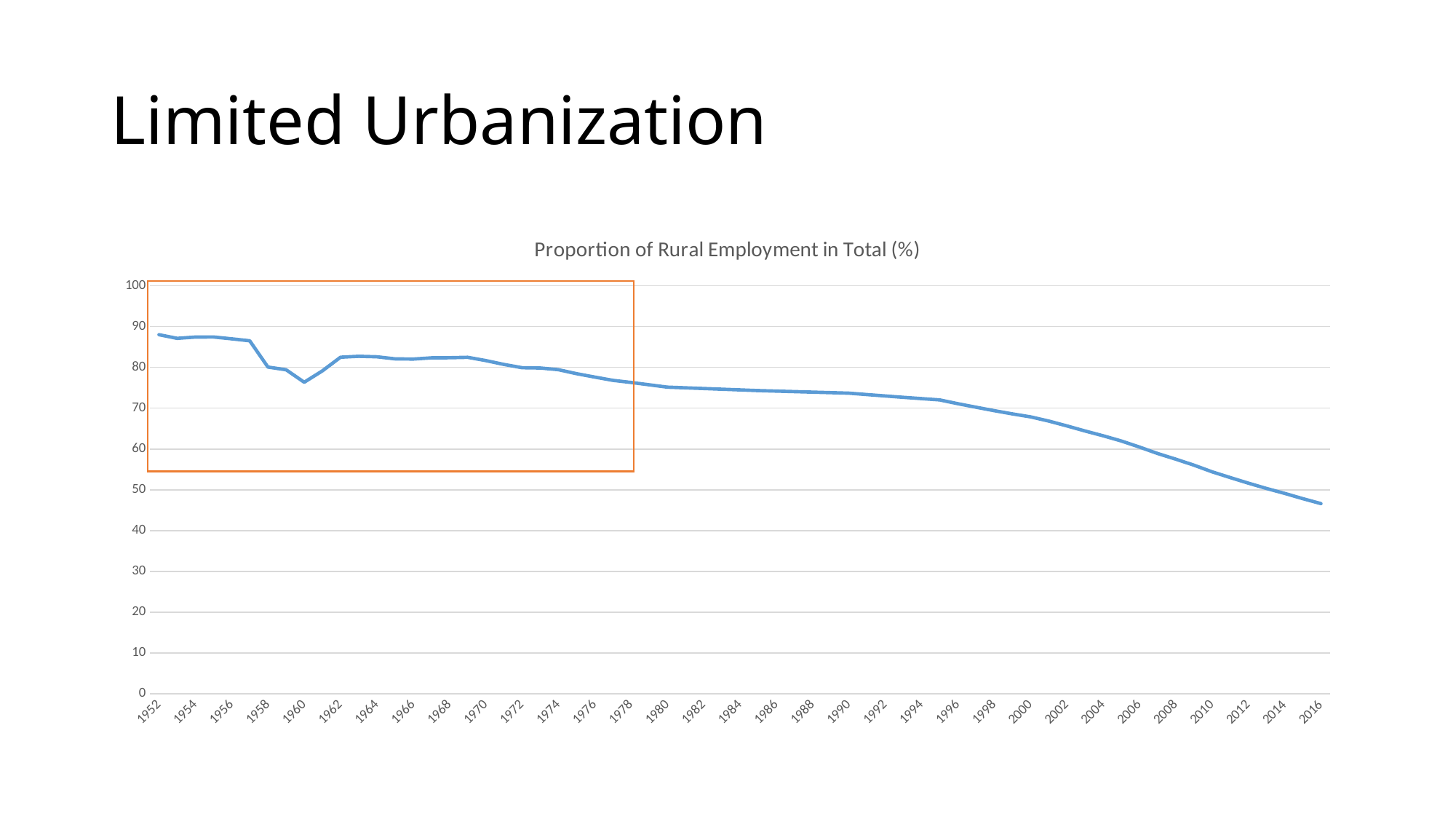
Is the value for 2010 greater or less than 60? less Which year has the larger value, 1960 or 1962? 1962 Overall, do the values rise or fall from 1952 to 2016? fall How many year labels are shown on the x axis? 33 What kind of chart is shown on the slide? line chart Is the value for 2004 greater or less than 70? less Is the value for 1952 greater or less than 80? greater Which year has the larger value, 1980 or 2008? 1980 Which year has the lowest value on the chart? 2016 What is the title of the chart? Proportion of Rural Employment in Total (%)